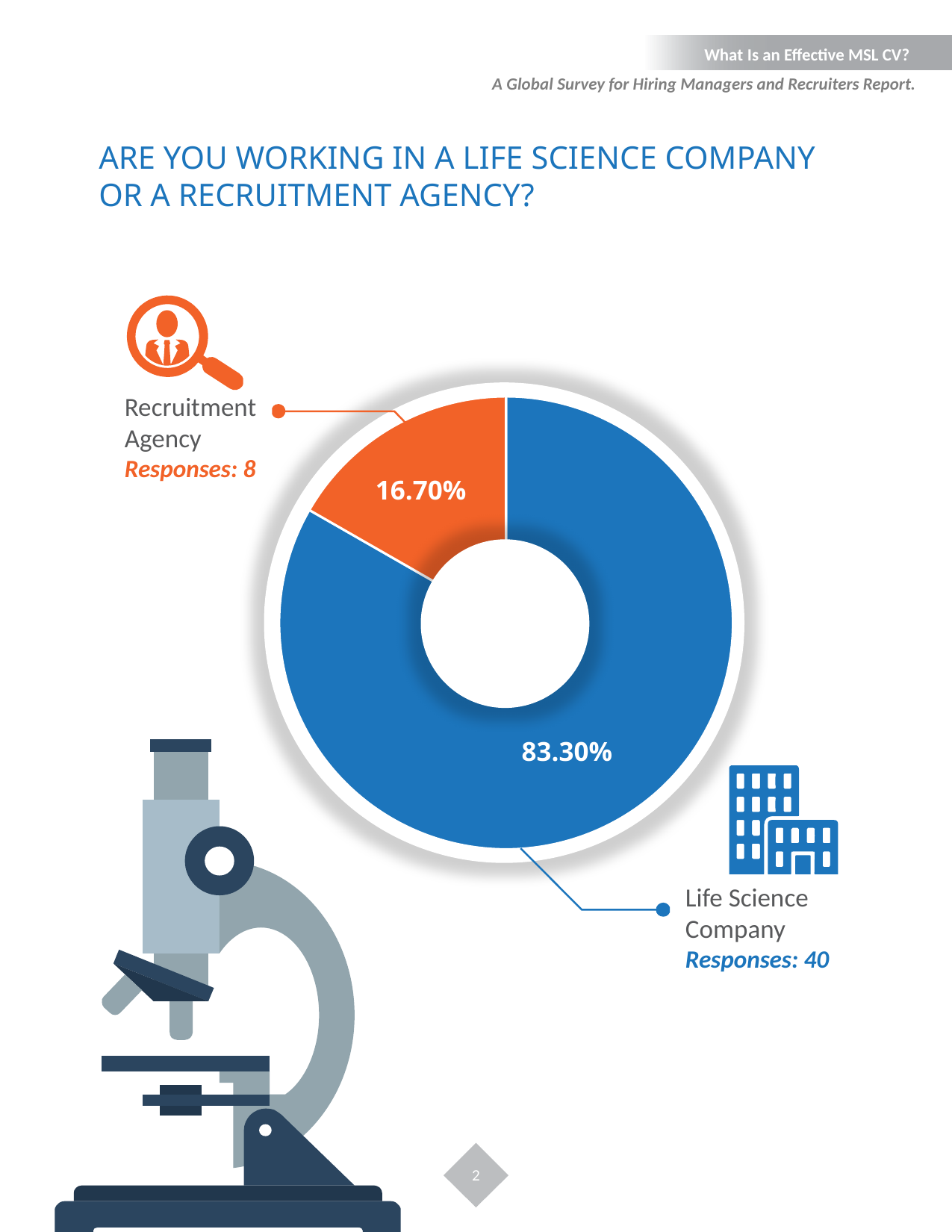
What is the total number of responses across both categories? 48 What colour is the Recruitment Agency slice? Orange Which category has the smallest share of the chart? Recruitment Agency Which has more responses, Life Science Company or Recruitment Agency? Life Science Company How many categories are shown in the chart? 2 How many responses came from Life Science Company respondents? 40 What is the difference in percentage points between the Life Science Company share and the Recruitment Agency share? 66.60% How many responses came from Recruitment Agency respondents? 8 Which category has the largest share of the chart? Life Science Company What percentage of respondents work in a Life Science Company? 83.30% What kind of chart is shown on the slide? Pie chart (donut) What percentage of respondents work in a Recruitment Agency? 16.70%